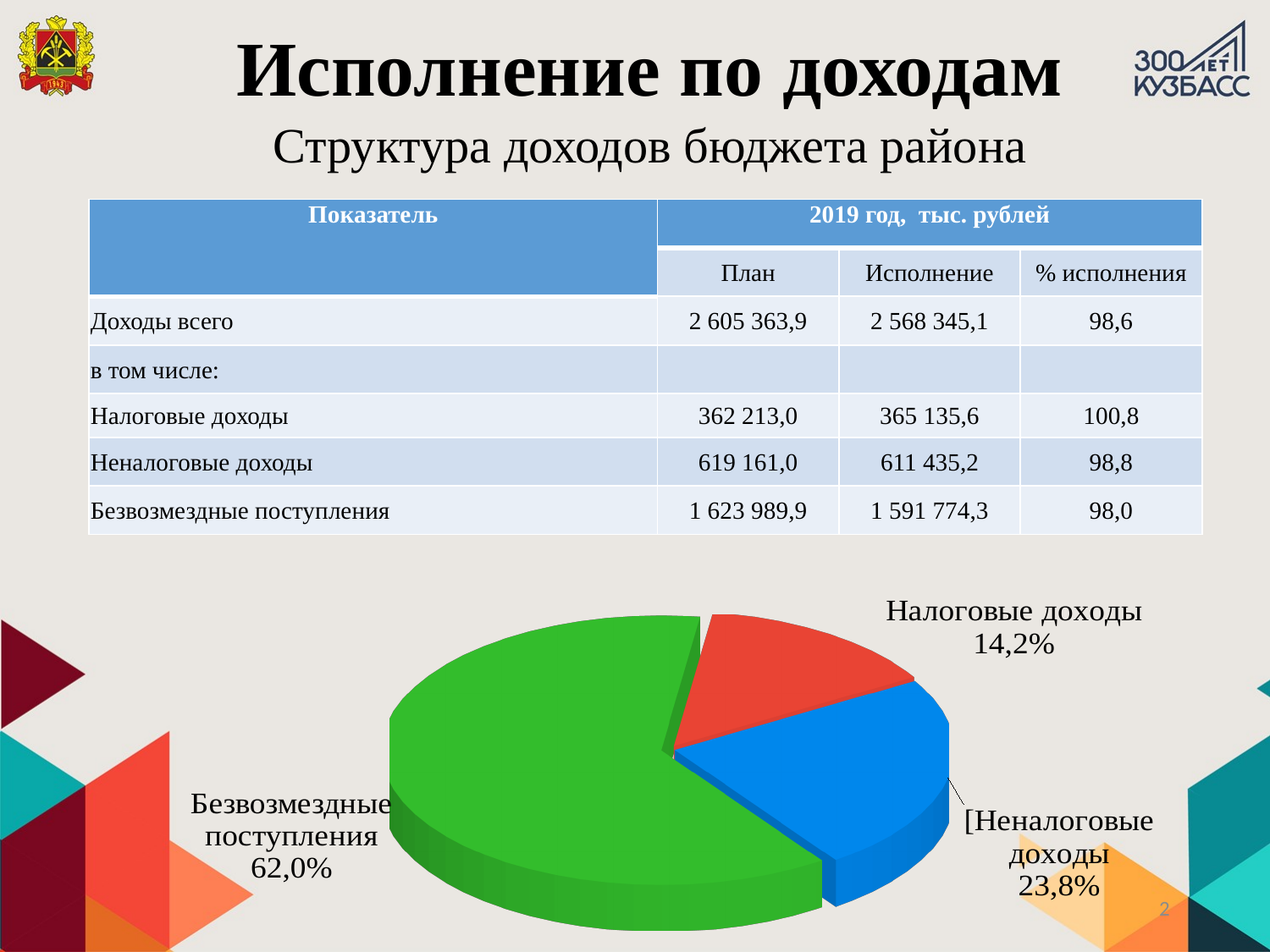
Which is larger in the pie chart, Неналоговые доходы or Налоговые доходы? Неналоговые доходы How many slices does the pie chart have? 3 What share of the pie does Неналоговые доходы have? 23,8% What share of the pie does Безвозмездные поступления have? 62,0% What is the difference in percentage points between Неналоговые доходы and Налоговые доходы in the pie chart? 9,6 What colour is the Безвозмездные поступления slice in the pie chart? green What is the difference in percentage points between Безвозмездные поступления and Неналоговые доходы in the pie chart? 38,2 What kind of chart is shown at the bottom of the slide? pie chart Which slice of the pie chart is the largest? Безвозмездные поступления What share of the pie does Налоговые доходы have? 14,2% What colour is the Налоговые доходы slice in the pie chart? red Which slice of the pie chart is the smallest? Налоговые доходы